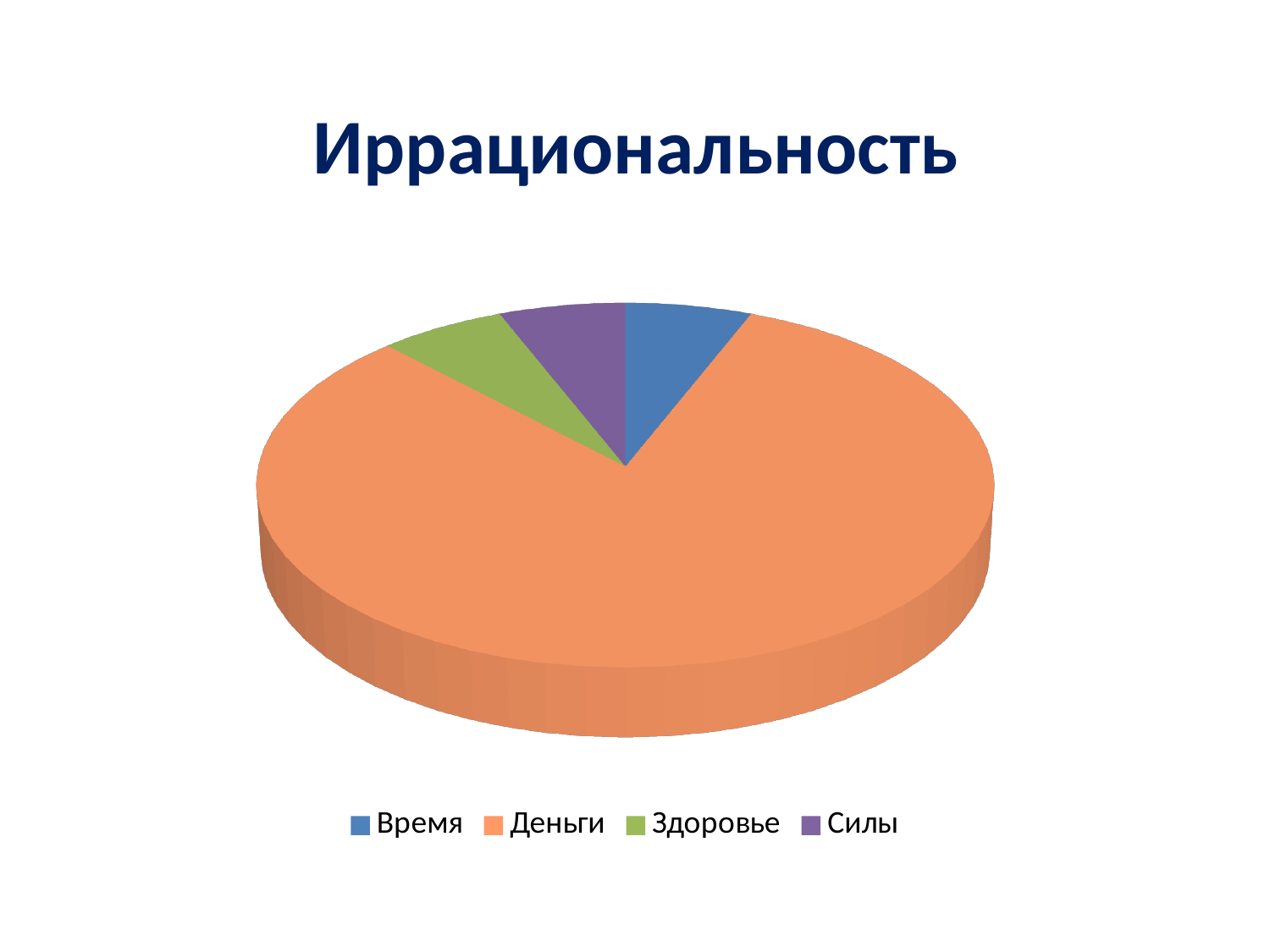
What kind of chart is shown on the slide? pie chart What is the title of the chart? Иррациональность Which category has the largest slice of the pie? Деньги How many categories does the pie chart have? 4 What colour is the slice for Деньги? orange Which is larger, the slice for Силы or the slice for Деньги? Деньги Which category is shown in green in the legend? Здоровье Which is larger, the slice for Деньги or the slice for Время? Деньги Which is larger, the slice for Деньги or the slice for Здоровье? Деньги